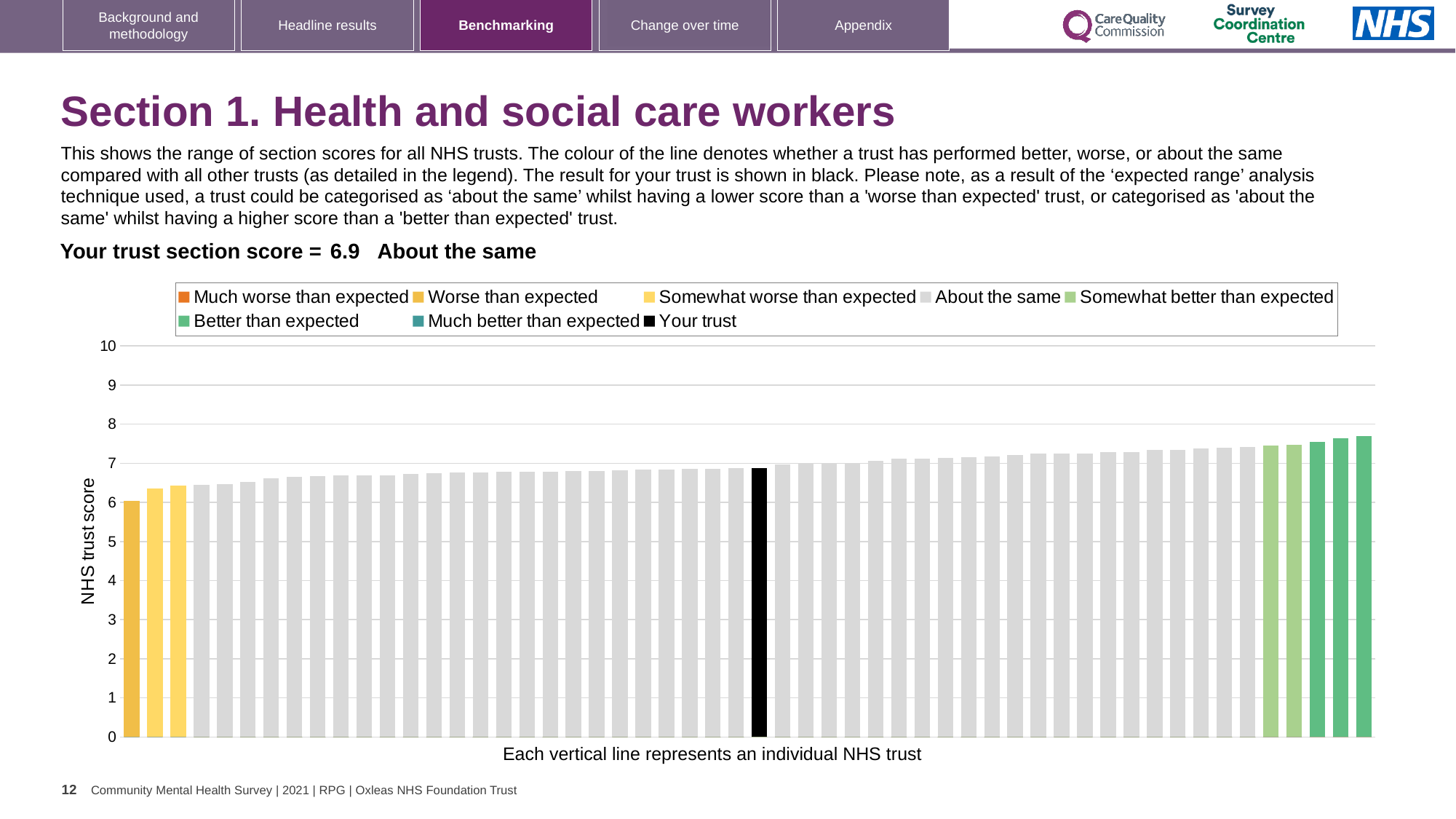
What kind of chart is shown on the slide? bar chart How many entries does the chart legend list? 8 Is the value of the black bar (your trust) greater or less than 8? less Is the value of the black bar (your trust) greater or less than 5? greater What is the highest value shown on the vertical axis of the chart? 10 Do the bar values rise or fall from left to right across the chart? rise What is the section score for your trust shown on the slide? 6.9 Which category is your trust placed in for this section? About the same Is the value of the lowest bar in the chart greater or less than 5? greater What is the label on the vertical axis of the chart? NHS trust score What colour is the bar representing your trust in the chart? black